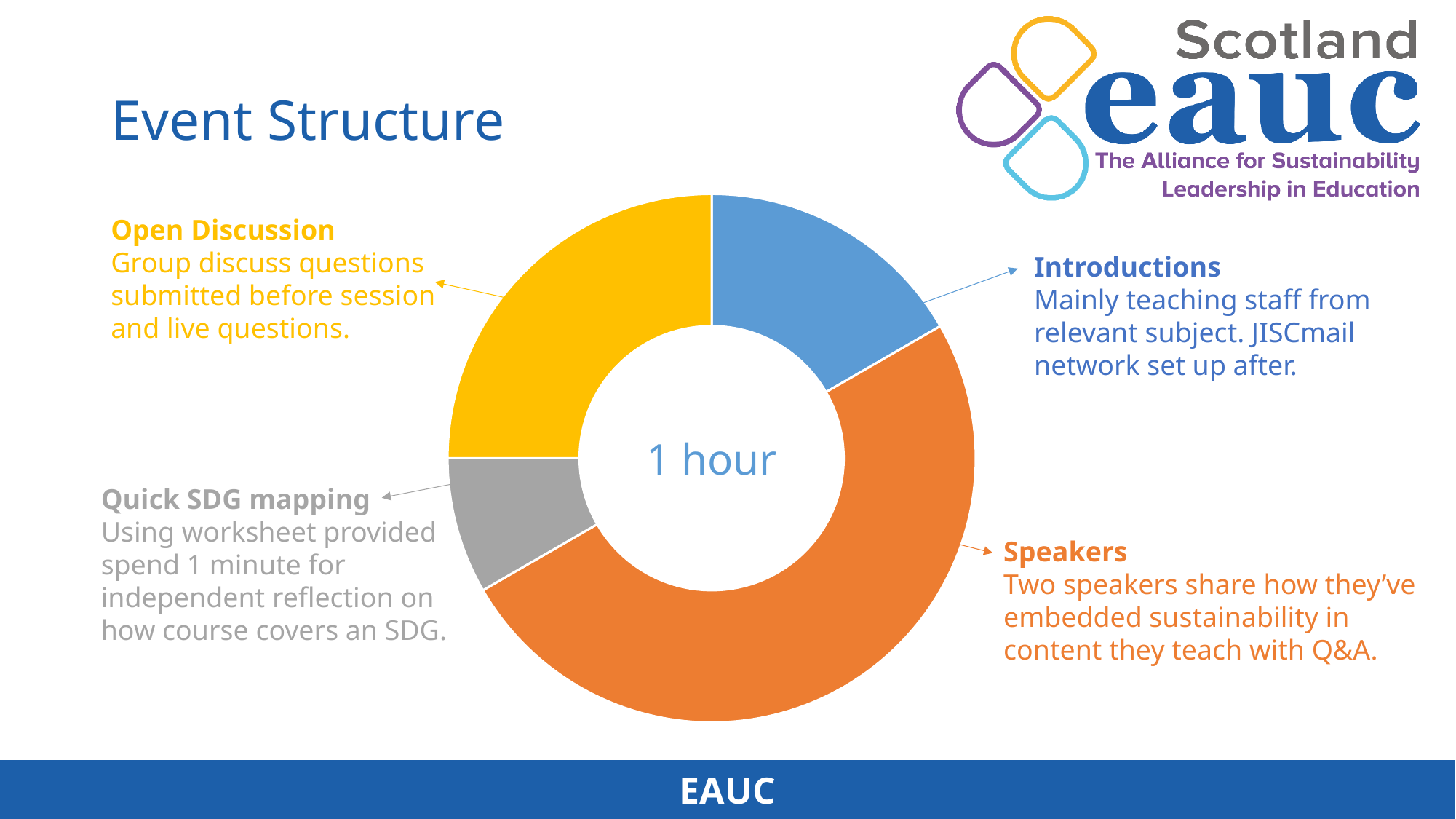
What text is shown in the centre of the doughnut chart? 1 hour Which segment is larger, Introductions or Quick SDG mapping? Introductions Which segment is larger, Open Discussion or Introductions? Open Discussion Which segment of the doughnut chart is the smallest? Quick SDG mapping Which segment is larger, Open Discussion or Quick SDG mapping? Open Discussion How many segments does the doughnut chart have? 4 What colour is the Speakers segment of the doughnut chart? Orange Which segment of the doughnut chart is the largest? Speakers What kind of chart is shown on the slide? Doughnut chart